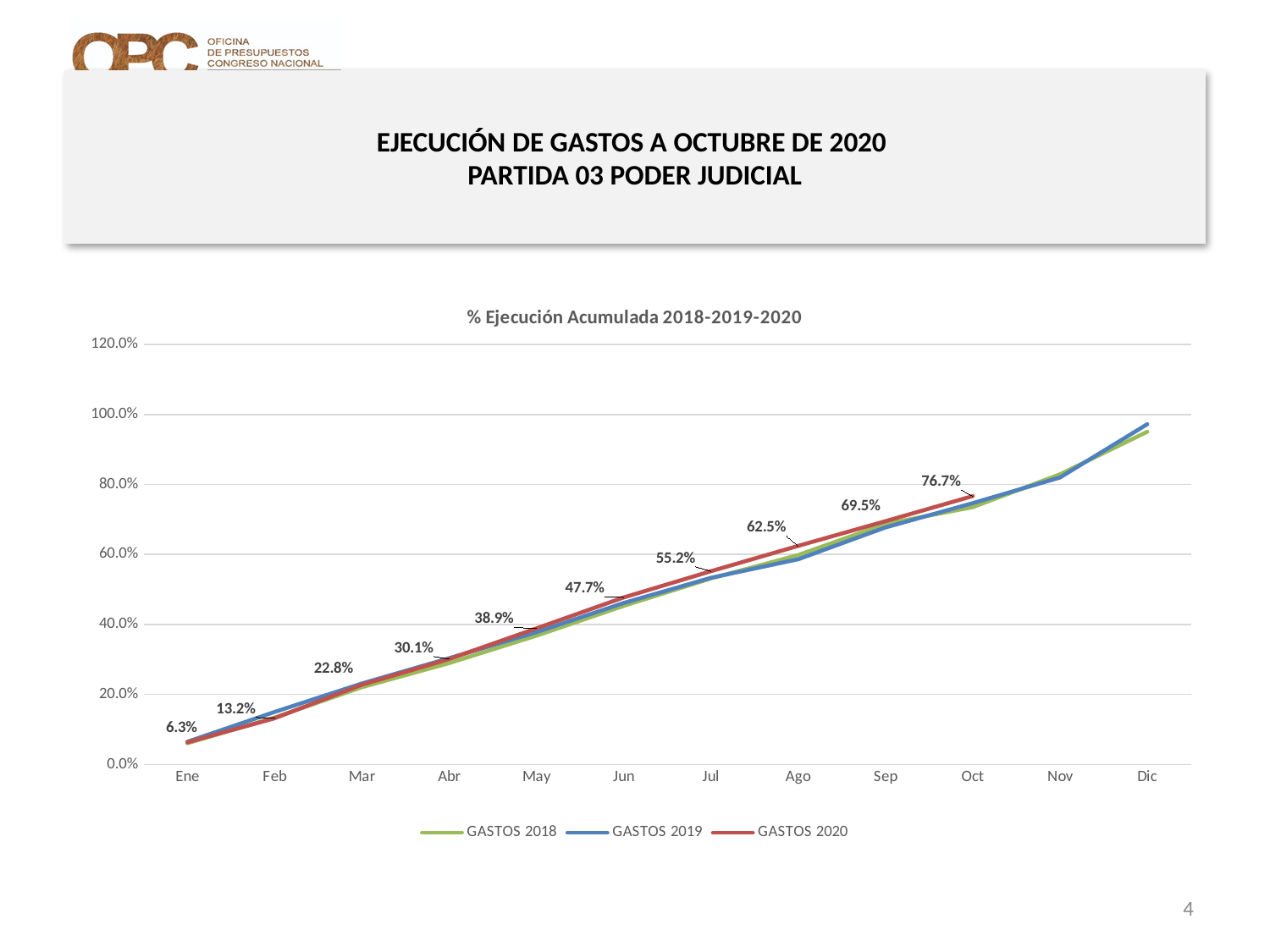
How many series does the legend list? 3 What is the difference between the GASTOS 2020 values for Oct and Sep? 7.2% What is the title of the chart? % Ejecución Acumulada 2018-2019-2020 What is the value for GASTOS 2020 in Ene? 6.3% In which month does GASTOS 2020 reach its highest labelled value? Oct What is the value for GASTOS 2020 in Mar? 22.8% What is the value for GASTOS 2020 in Oct? 76.7% What is the value for GASTOS 2020 in Jun? 47.7% Do the GASTOS 2020 values rise or fall from Ene to Oct? Rise How many months are shown on the x axis? 12 What type of chart is shown on the slide? Line chart Is the value for GASTOS 2019 in Dic greater or less than 80.0%? greater